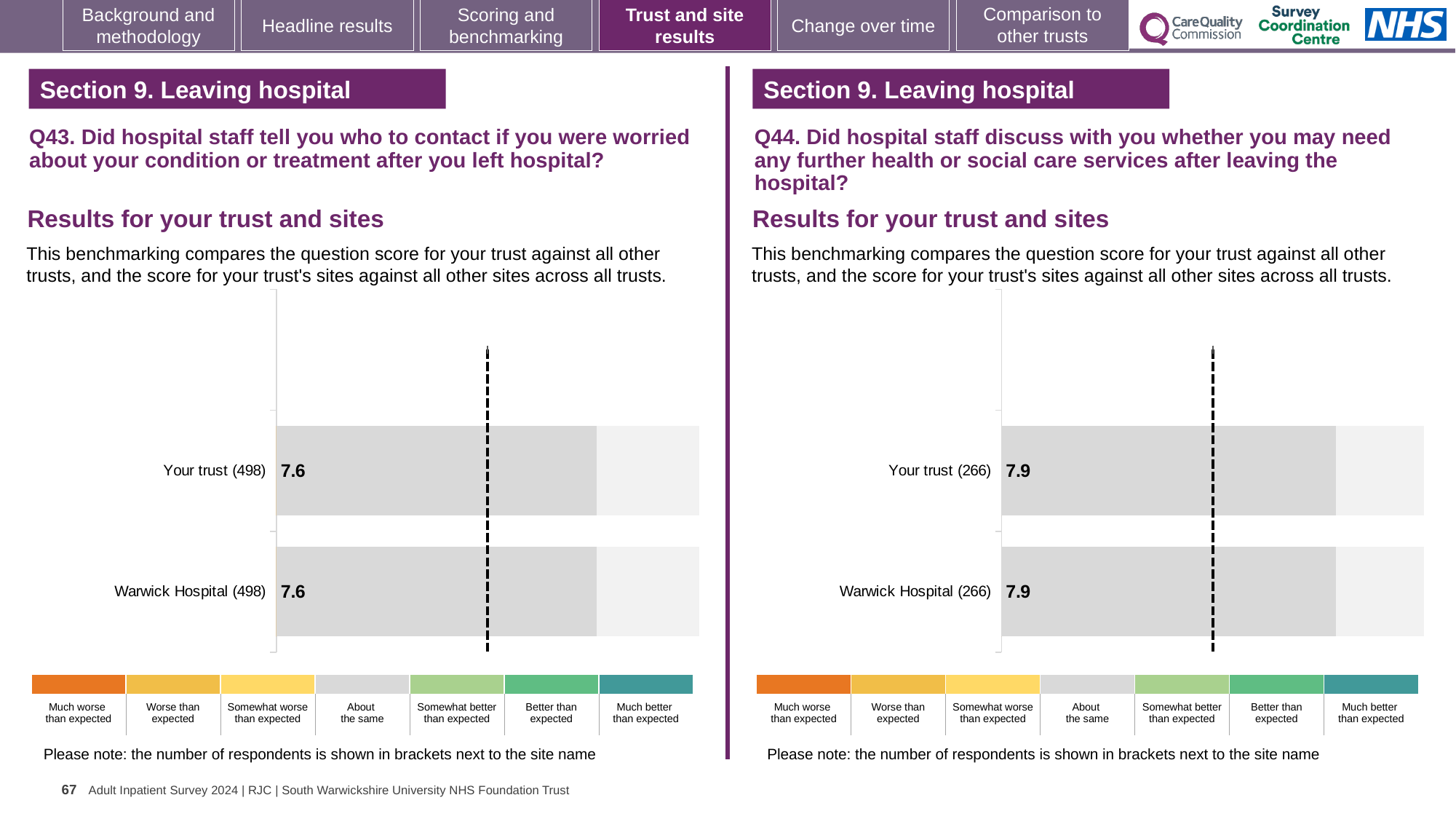
How many bars are plotted on the left chart (Q43)? 2 On the right chart (Q44), what is the score for Your trust? 7.9 On the left chart (Q43), what is the score for Warwick Hospital? 7.6 How many bars are plotted on the right chart (Q44)? 2 On the left chart (Q43), what is the difference between the score for Your trust and the score for Warwick Hospital? 0 How many respondents are shown in brackets for Your trust on the right chart (Q44)? 266 On the right chart (Q44), what is the difference between the score for Your trust and the score for Warwick Hospital? 0 According to the colour key, which category do the grey bars on the left chart (Q43) represent? About the same What kind of chart is used on the left (Q43)? Bar chart On the right chart (Q44), what is the score for Warwick Hospital? 7.9 How many respondents are shown in brackets for Warwick Hospital on the left chart (Q43)? 498 On the left chart (Q43), what is the score for Your trust? 7.6